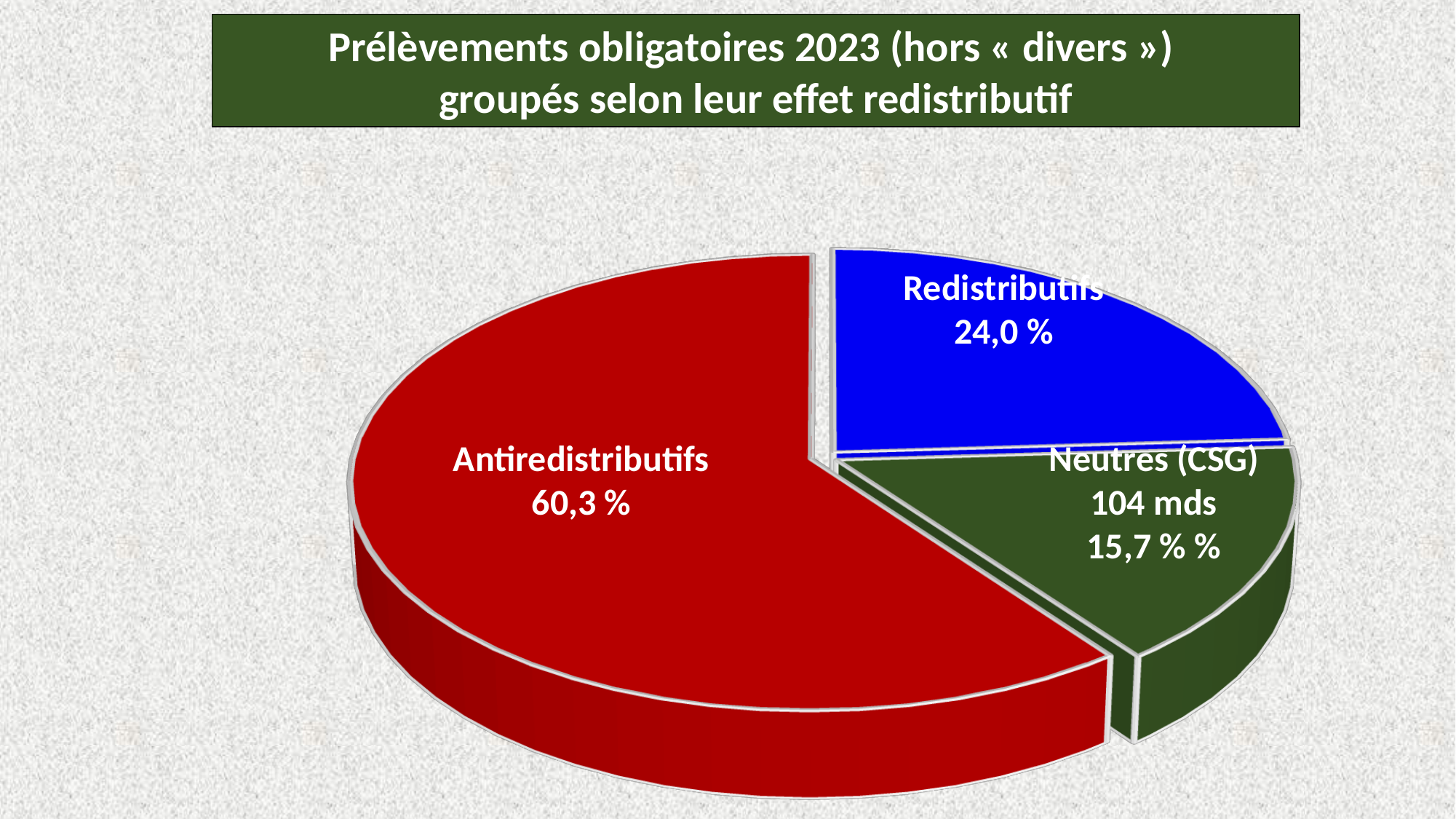
What share of the pie is labelled for Redistributifs? 24,0 % Which is larger, the Redistributifs slice or the Neutres (CSG) slice? Redistributifs What share of the pie is labelled for Antiredistributifs? 60,3 % What kind of chart is shown on the slide? pie chart What is the title of the chart? Prélèvements obligatoires 2023 (hors « divers ») groupés selon leur effet redistributif What amount in mds is printed on the Neutres (CSG) slice? 104 mds What percentage is shown for the Neutres (CSG) slice? 15,7 % Which slice of the pie is the smallest? Neutres (CSG) What is the difference in percentage points between the Antiredistributifs and Redistributifs slices? 36,3 What colour is the Antiredistributifs slice? red How many slices does the pie chart have? 3 Which slice of the pie is the largest? Antiredistributifs